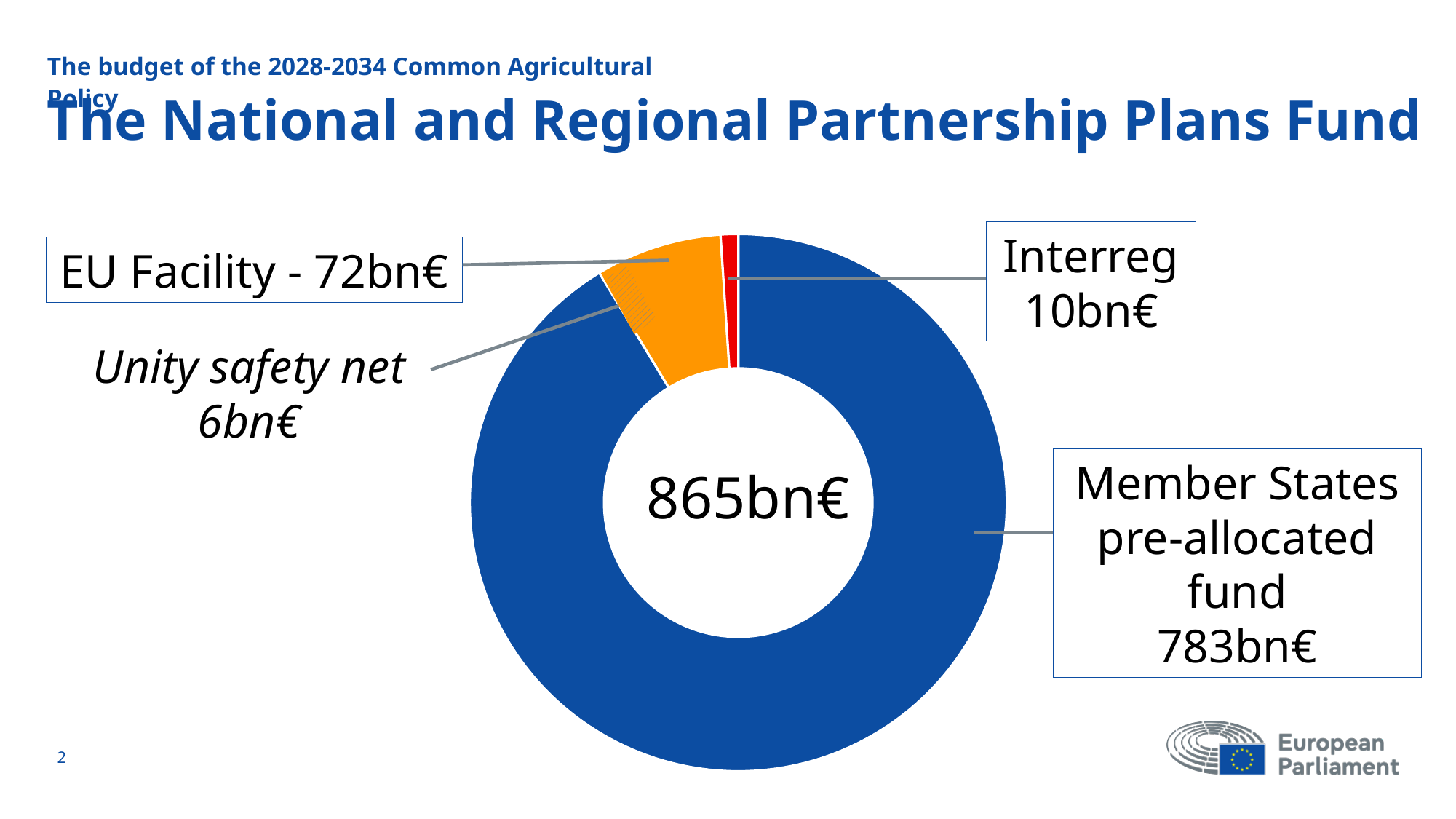
What is the value shown for the Unity safety net? 6bn€ Which labelled amount on the chart is the smallest? Unity safety net (6bn€) Which component of the fund is the largest? Member States pre-allocated fund What is the value of the Member States pre-allocated fund in the chart? 783bn€ What is the difference between the EU Facility and Interreg amounts? 62bn€ Which is larger, the EU Facility or Interreg? EU Facility What total amount is printed in the centre of the chart? 865bn€ What is the value shown for the EU Facility? 72bn€ What kind of chart is shown on the slide? Doughnut (pie) chart How much larger is the Member States pre-allocated fund than the EU Facility? 711bn€ What is the value shown for Interreg? 10bn€ What colour is the Member States pre-allocated fund segment? Blue